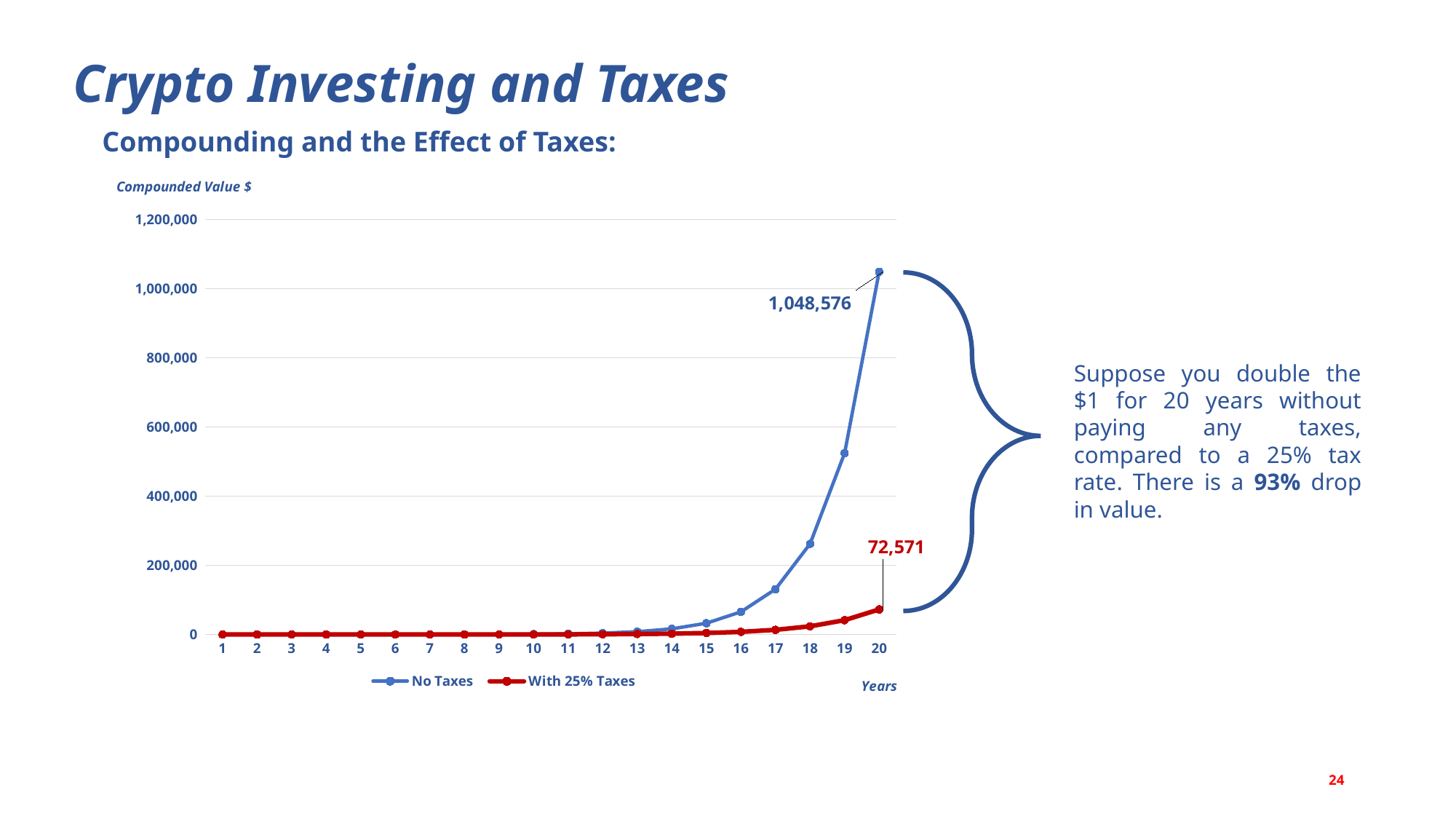
Does the No Taxes series rise or fall as the years increase? rise Which series has the larger value at year 20, No Taxes or With 25% Taxes? No Taxes Is the value of the No Taxes series at year 18 greater or less than 400,000? less How many years are plotted along the x axis? 20 What is the difference between the No Taxes value and the With 25% Taxes value at year 20? 976,005 What is the label of the y axis? Compounded Value $ How many series does the legend list? 2 What type of chart is shown on the slide? line chart What is the value of the With 25% Taxes series at year 20? 72,571 Is the value of the No Taxes series at year 19 greater or less than 400,000? greater What is the value of the No Taxes series at year 20? 1,048,576 What colour is the line for the With 25% Taxes series? red